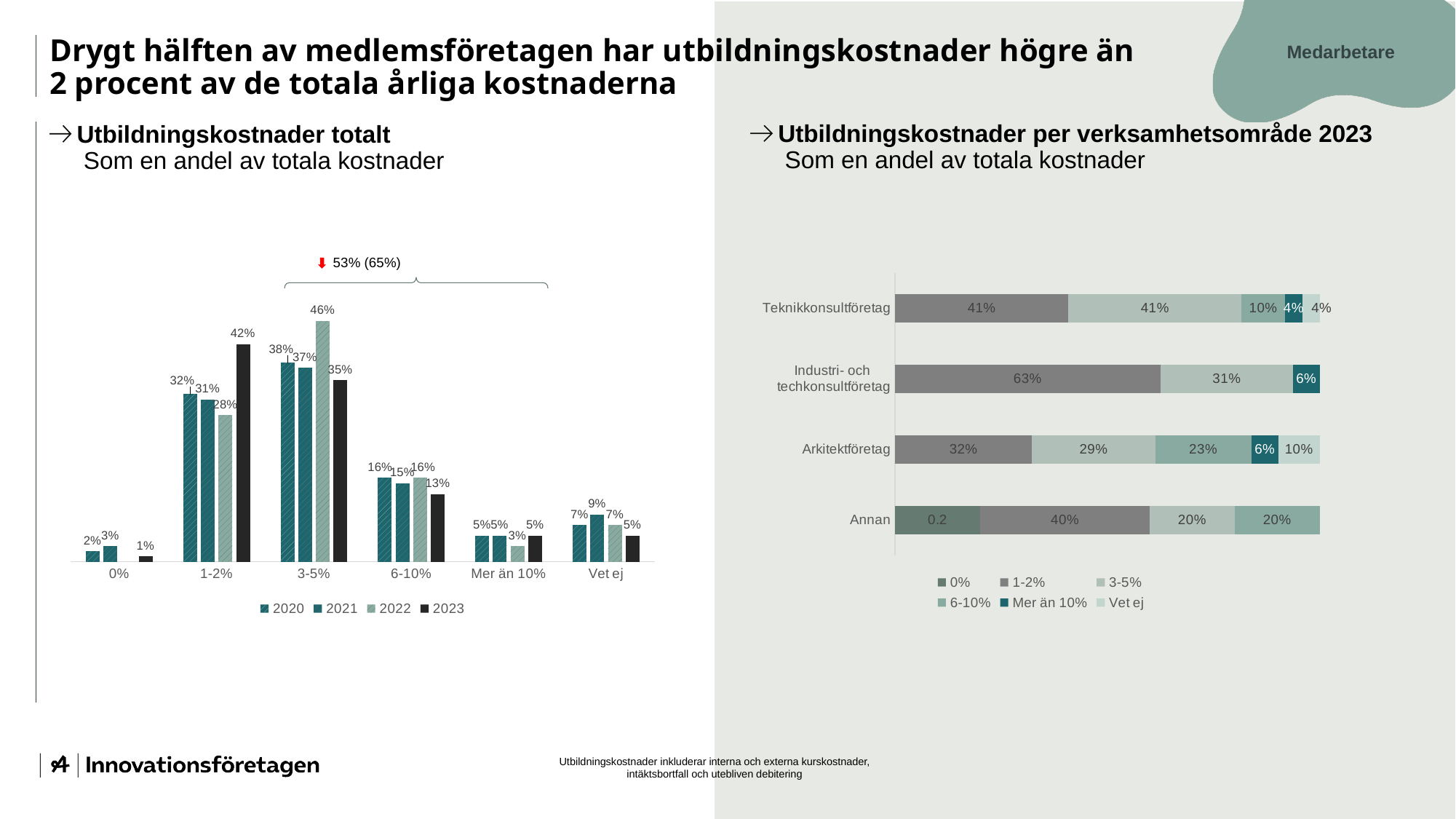
In the left chart 'Utbildningskostnader totalt', what is the value for 2023 in the '1-2%' category? 42% How many series does the legend of the left chart 'Utbildningskostnader totalt' list? 4 In the right chart 'Utbildningskostnader per verksamhetsområde 2023', what is the '6-10%' value for Arkitektföretag? 23% In the left chart 'Utbildningskostnader totalt', which year has the highest value in the '3-5%' category? 2022 In the right chart 'Utbildningskostnader per verksamhetsområde 2023', which category has the highest '1-2%' value? Industri- och techkonsultföretag In the left chart 'Utbildningskostnader totalt', which is larger: the 2021 value for 'Vet ej' or the 2023 value for 'Vet ej'? 2021 How many categories are shown on the x axis of the left chart 'Utbildningskostnader totalt'? 6 How many series does the legend of the right chart 'Utbildningskostnader per verksamhetsområde 2023' list? 6 In the left chart 'Utbildningskostnader totalt', what is the value for 2022 in the '3-5%' category? 46% What kind of chart is the right chart 'Utbildningskostnader per verksamhetsområde 2023'? Stacked bar chart In the right chart 'Utbildningskostnader per verksamhetsområde 2023', what is the '1-2%' value for Industri- och techkonsultföretag? 63% In the left chart 'Utbildningskostnader totalt', what is the difference between the 2023 and 2022 values in the '1-2%' category? 14 percentage points